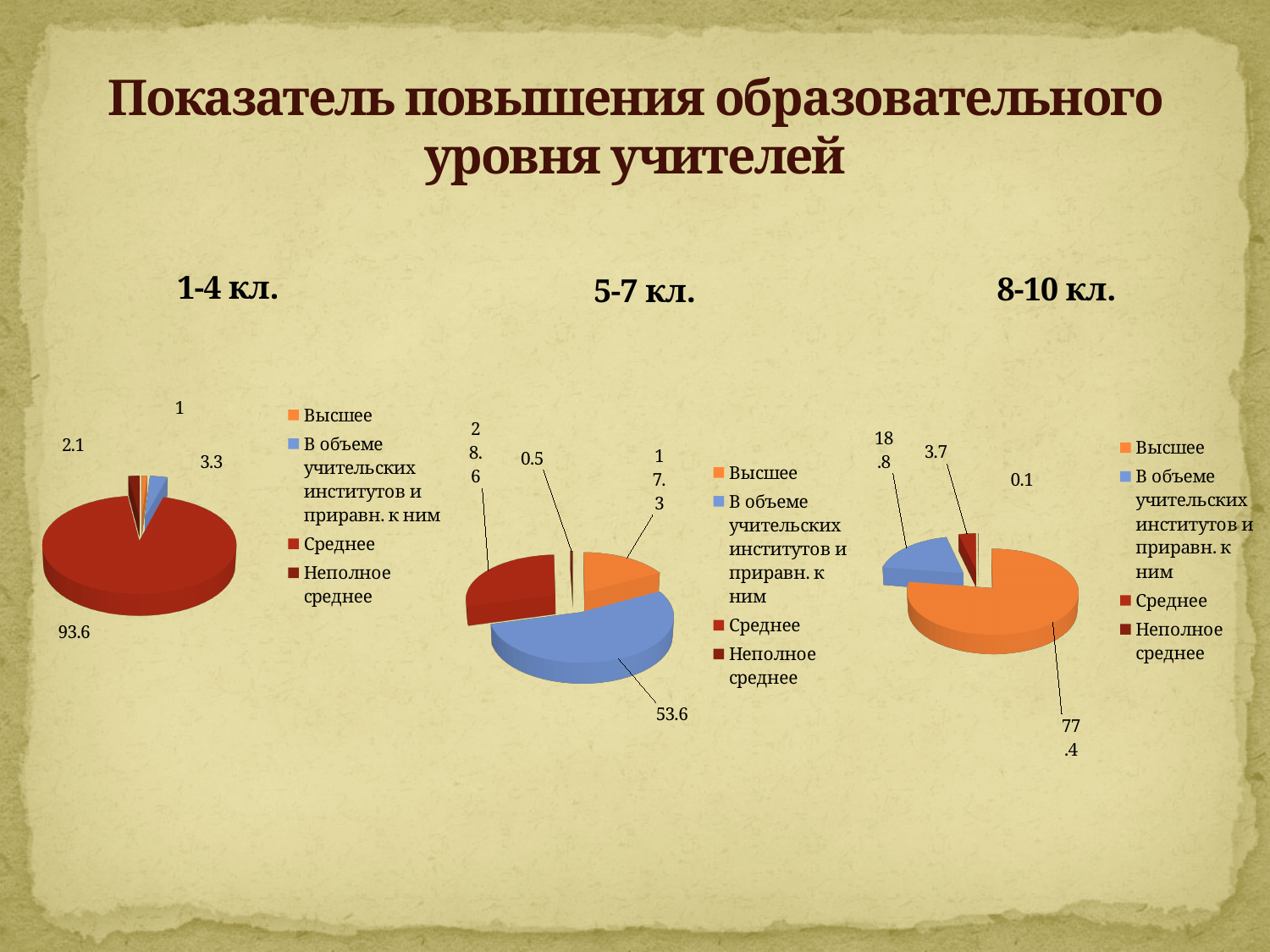
In the "5-7 кл." pie chart, which category has the largest slice? В объеме учительских институтов и приравн. к ним In the "1-4 кл." pie chart, what value is shown for the blue slice (В объеме учительских институтов и приравн. к ним)? 3.3 In the "8-10 кл." pie chart, which category has the smallest slice? Неполное среднее Which is larger: the Высшее slice in the "5-7 кл." chart or the Высшее slice in the "8-10 кл." chart? 8-10 кл. In the "8-10 кл." pie chart, what value is shown for the orange slice (Высшее)? 77.4 In the "5-7 кл." pie chart, what value is shown for the blue slice (В объеме учительских институтов и приравн. к ним)? 53.6 What type of chart is used for "5-7 кл."? Pie chart In the "8-10 кл." pie chart, what is the difference between the Высшее slice (77.4) and the blue slice (18.8)? 58.6 How many categories does the legend of the "1-4 кл." chart list? 4 In the "8-10 кл." pie chart, what value is shown for the blue slice (В объеме учительских институтов и приравн. к ним)? 18.8 In the "1-4 кл." pie chart, what value is shown for the largest slice (Среднее)? 93.6 In the "5-7 кл." pie chart, what value is shown for the orange slice (Высшее)? 17.3